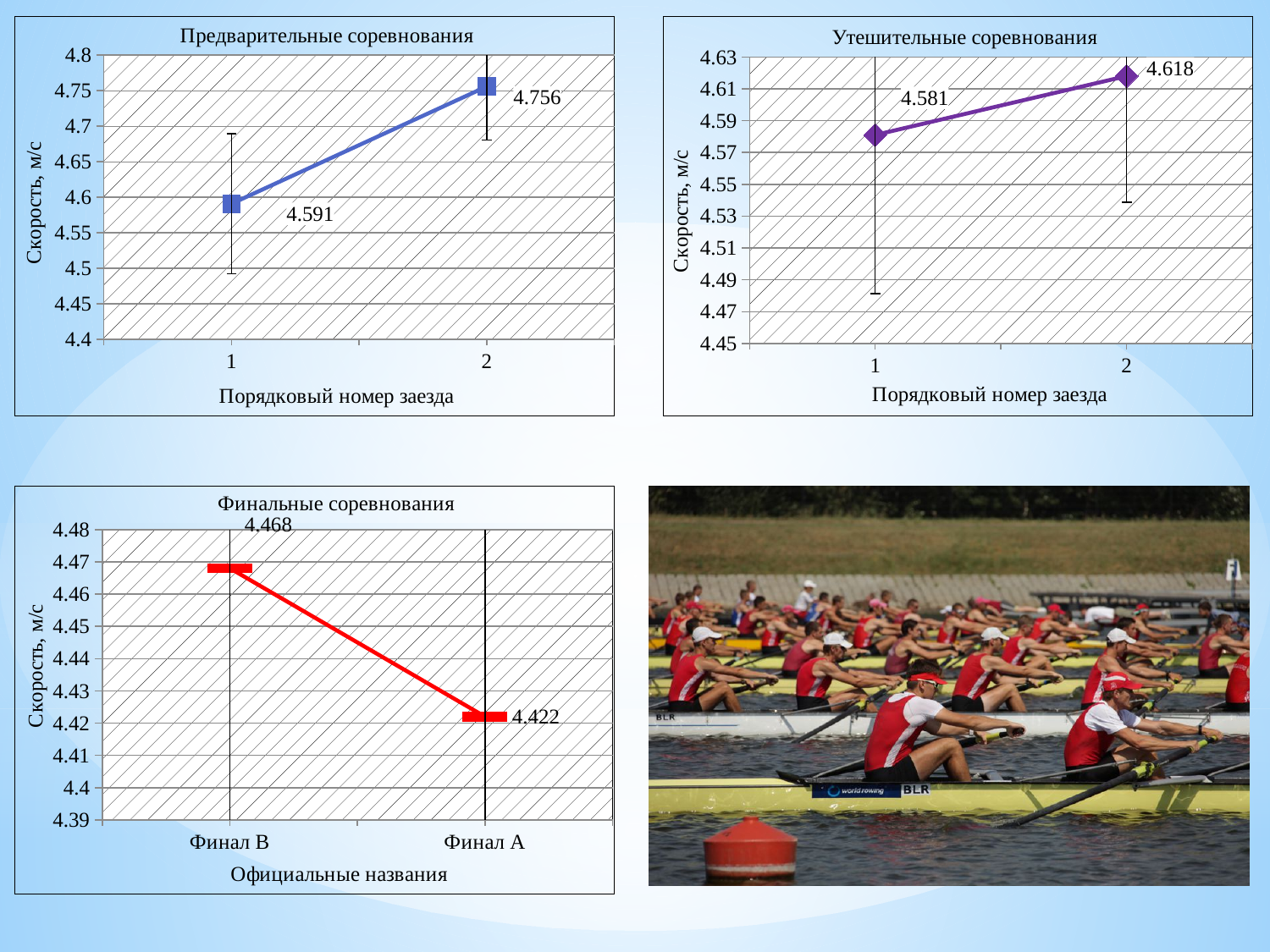
In the chart titled "Предварительные соревнования", what is the difference between the values for race 2 and race 1? 0.165 In the chart titled "Предварительные соревнования", what is the speed value for race number 1? 4.591 In the chart titled "Утешительные соревнования", what is the speed value for race number 1? 4.581 In the chart titled "Утешительные соревнования", what is the speed value for race number 2? 4.618 In the chart titled "Предварительные соревнования", do the values rise or fall from race 1 to race 2? rise In the chart titled "Финальные соревнования", which category has the lower speed? Финал A In the chart titled "Финальные соревнования", what is the speed value for Финал A? 4.422 What is the y-axis label of the chart titled "Финальные соревнования"? Скорость, м/с In the chart titled "Финальные соревнования", what is the difference between the values for Финал B and Финал A? 0.046 In the chart titled "Финальные соревнования", what is the speed value for Финал B? 4.468 In the chart titled "Утешительные соревнования", which race number has the higher speed? 2 In the chart titled "Предварительные соревнования", what is the speed value for race number 2? 4.756